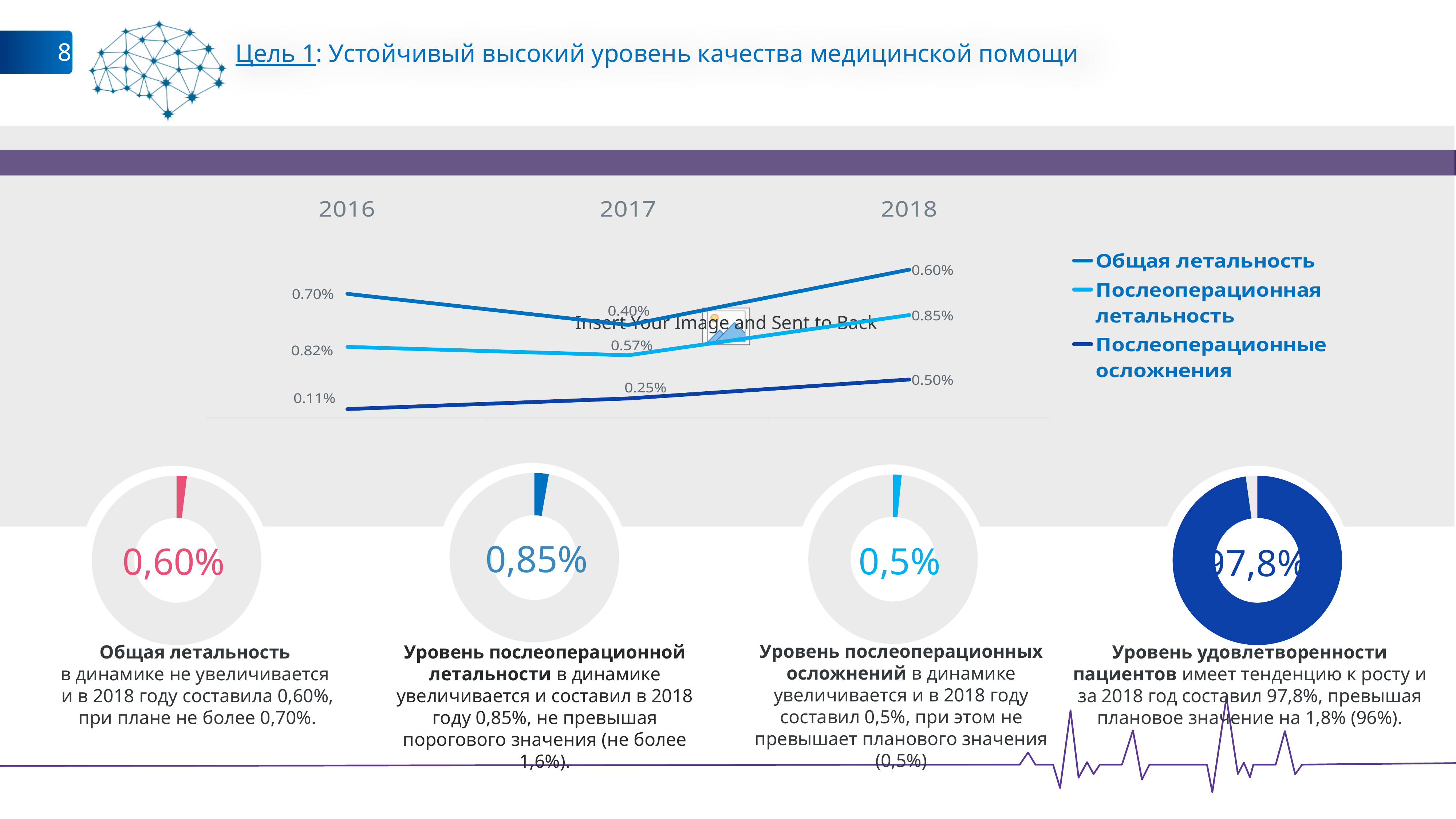
In the line chart, how many series does the legend list? 3 In the line chart, how many years are shown on the x axis? 3 In the line chart, what is the value of Послеоперационная летальность in 2017? 0.57% In the line chart, what is the value of Послеоперационные осложнения in 2018? 0.50% In the line chart, what is the value of Послеоперационные осложнения in 2016? 0.11% What kind of chart is the chart at the top of the slide showing values by year? line chart In the line chart, what is the value of Общая летальность in 2017? 0.40% In the line chart, what is the value of Общая летальность in 2016? 0.70% In the line chart, do the values for Послеоперационные осложнения rise or fall from 2016 to 2018? rise In the line chart, what is the difference between the Послеоперационные осложнения values in 2018 and 2016? 0.39% What value is shown in the donut chart labelled Уровень удовлетворенности пациентов at the bottom right of the slide? 97,8% What value is shown in the donut chart labelled Уровень послеоперационных осложнений? 0,5%